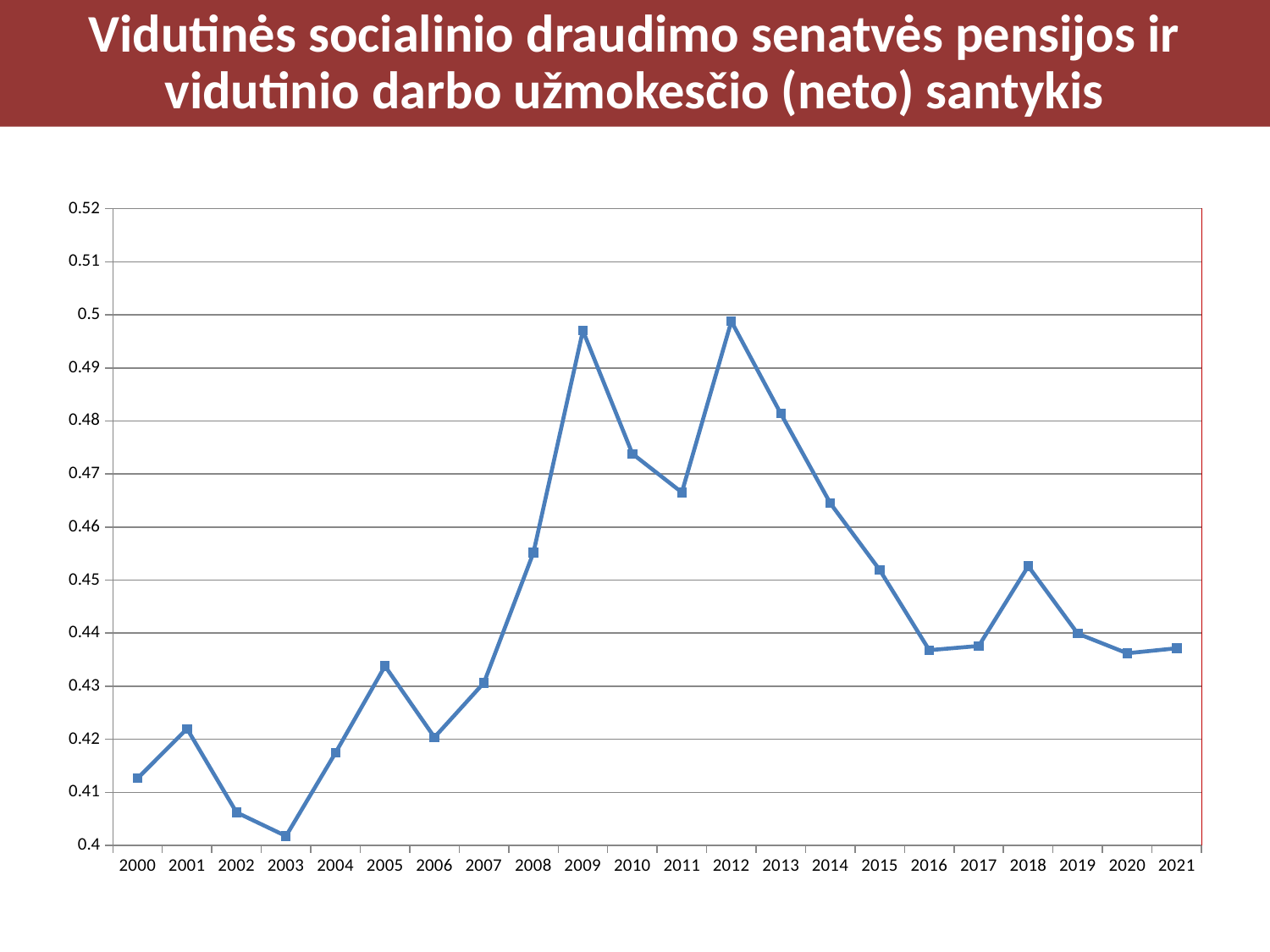
Which year has the larger value, 2014 or 2015? 2014 Is the value for 2018 greater or less than 0.45? greater Is the value for 2016 greater or less than 0.44? less What kind of chart is shown on the slide? line chart Do the values rise or fall from 2012 to 2016? fall Which year has the lowest value on the chart? 2003 Is the value for 2003 greater or less than 0.41? less Do the values rise or fall from 2006 to 2009? rise How many years are plotted along the x axis? 22 Which year has the larger value, 2009 or 2010? 2009